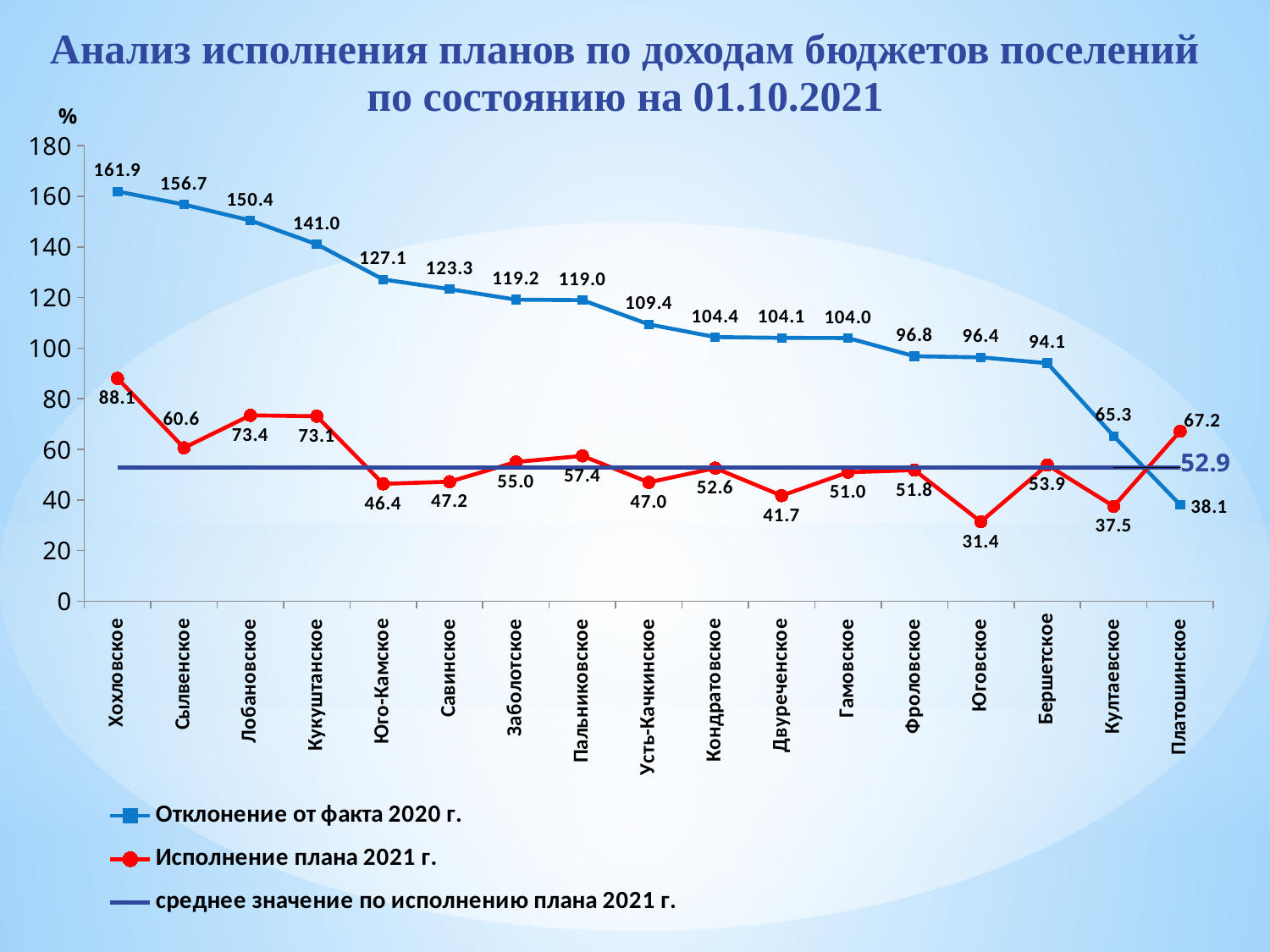
Which settlement has the lowest value for «Отклонение от факта 2020 г.»? Платошинское What is the value of the line «среднее значение по исполнению плана 2021 г.»? 52.9 Is the value of «Отклонение от факта 2020 г.» for Кукуштанское greater or less than 120? greater What is the value of «Исполнение плана 2021 г.» for Платошинское? 67.2 How many settlements are shown on the x axis? 17 Which is larger for Култаевское: «Отклонение от факта 2020 г.» or «Исполнение плана 2021 г.»? Отклонение от факта 2020 г. How many entries does the legend list? 3 What is the value of «Отклонение от факта 2020 г.» for Хохловское? 161.9 What is the difference between the «Отклонение от факта 2020 г.» values for Сылвенское and Лобановское? 6.3 What is the value of «Исполнение плана 2021 г.» for Юговское? 31.4 Which settlement has the highest value for «Исполнение плана 2021 г.»? Хохловское What kind of chart is shown on the slide? line chart